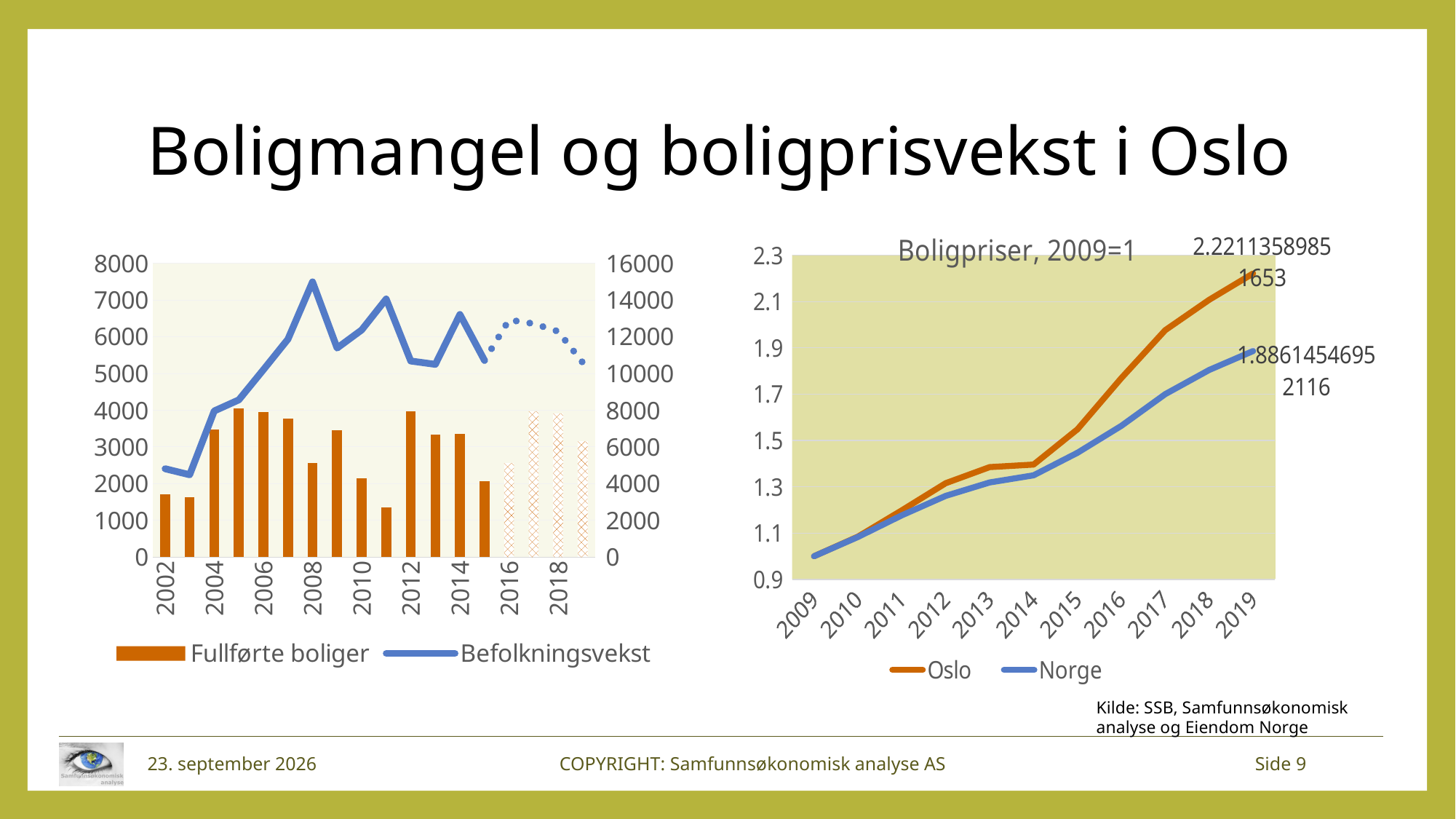
In the chart on the left of the slide, how many series does the legend list? 2 In the chart on the left of the slide, is the 'Fullførte boliger' value for 2011 greater or less than 2000? less In the chart on the left of the slide, is the 'Befolkningsvekst' value for 2008 greater or less than 14000 on the right axis? greater In the chart titled 'Boligpriser, 2009=1', is the value for Oslo in 2017 greater or less than 1.9? greater In the chart on the left of the slide, in which year does 'Befolkningsvekst' reach its highest value? 2008 In the chart titled 'Boligpriser, 2009=1', how many years are shown on the x axis? 11 In the chart titled 'Boligpriser, 2009=1', do the values for Oslo rise or fall from 2009 to 2019? rise In the chart on the left of the slide, what kind of chart is used for 'Fullførte boliger'? bar chart In the chart titled 'Boligpriser, 2009=1', which series has the higher value in 2019, Oslo or Norge? Oslo In the chart titled 'Boligpriser, 2009=1', how many series does the legend list? 2 In the chart titled 'Boligpriser, 2009=1', what is the data label shown for Oslo in 2019? 2.22113589851653 In the chart titled 'Boligpriser, 2009=1', what is the data label shown for Norge in 2019? 1.88614546952116